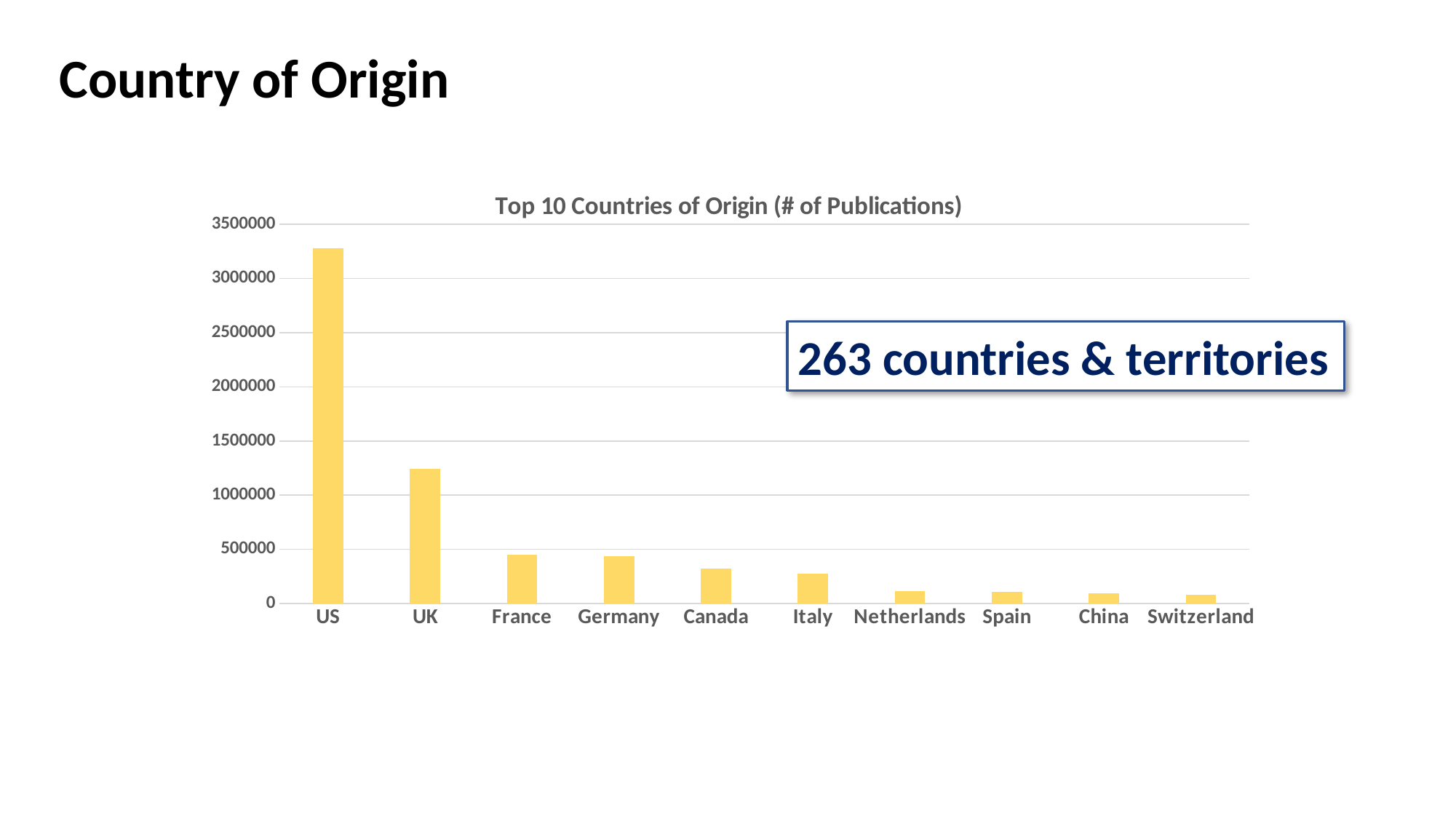
What is the title of the chart? Top 10 Countries of Origin (# of Publications) Do the values rise or fall moving from left to right along the x axis? Fall Is the value for France greater or less than 500000? less According to the text box on the slide, how many countries and territories are represented? 263 countries & territories Is the value for Netherlands greater or less than 500000? less Is the value for UK greater or less than 1000000? greater What kind of chart is shown on the slide? Bar chart How many countries are shown on the x axis of the chart? 10 Which country has the highest number of publications in the chart? US Which has more publications, UK or France? UK